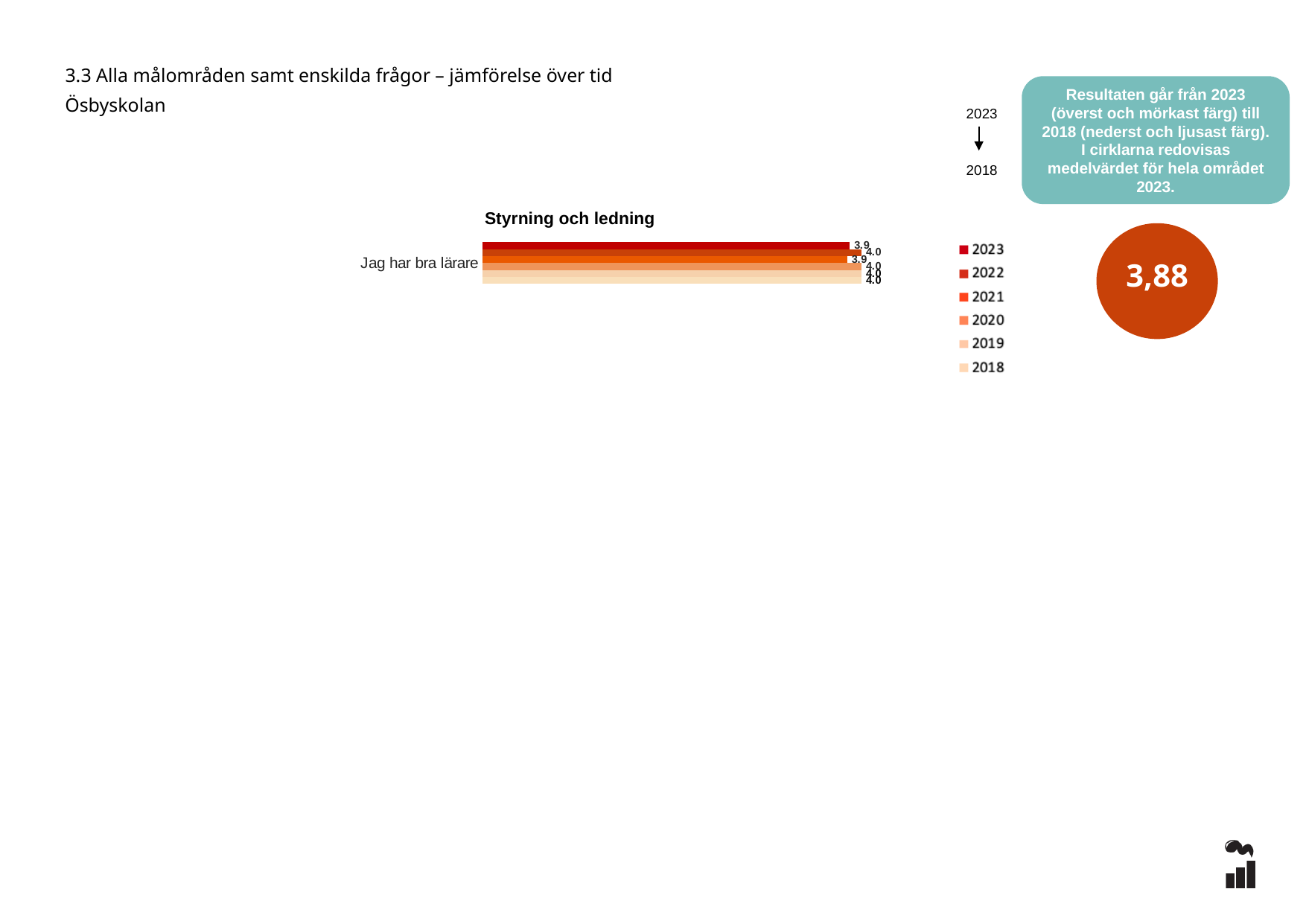
What mean value for the whole area in 2023 is shown in the circle next to the chart? 3,88 For "Jag har bra lärare", which year has the larger value, 2023 or 2022? 2022 What is the title of the chart on the slide? Styrning och ledning What kind of chart is shown under the title "Styrning och ledning"? bar chart What is the value for "Jag har bra lärare" in 2023? 3.9 How many series does the legend of the "Styrning och ledning" chart list? 6 What is the value for "Jag har bra lärare" in 2022? 4.0 How many categories (questions) are plotted in the "Styrning och ledning" chart? 1 What is the difference between the 2022 and 2023 values for "Jag har bra lärare"? 0.1 What is the value for "Jag har bra lärare" in 2018? 4.0 What is the value for "Jag har bra lärare" in 2021? 3.9 Which year is listed first (at the top) in the chart legend? 2023